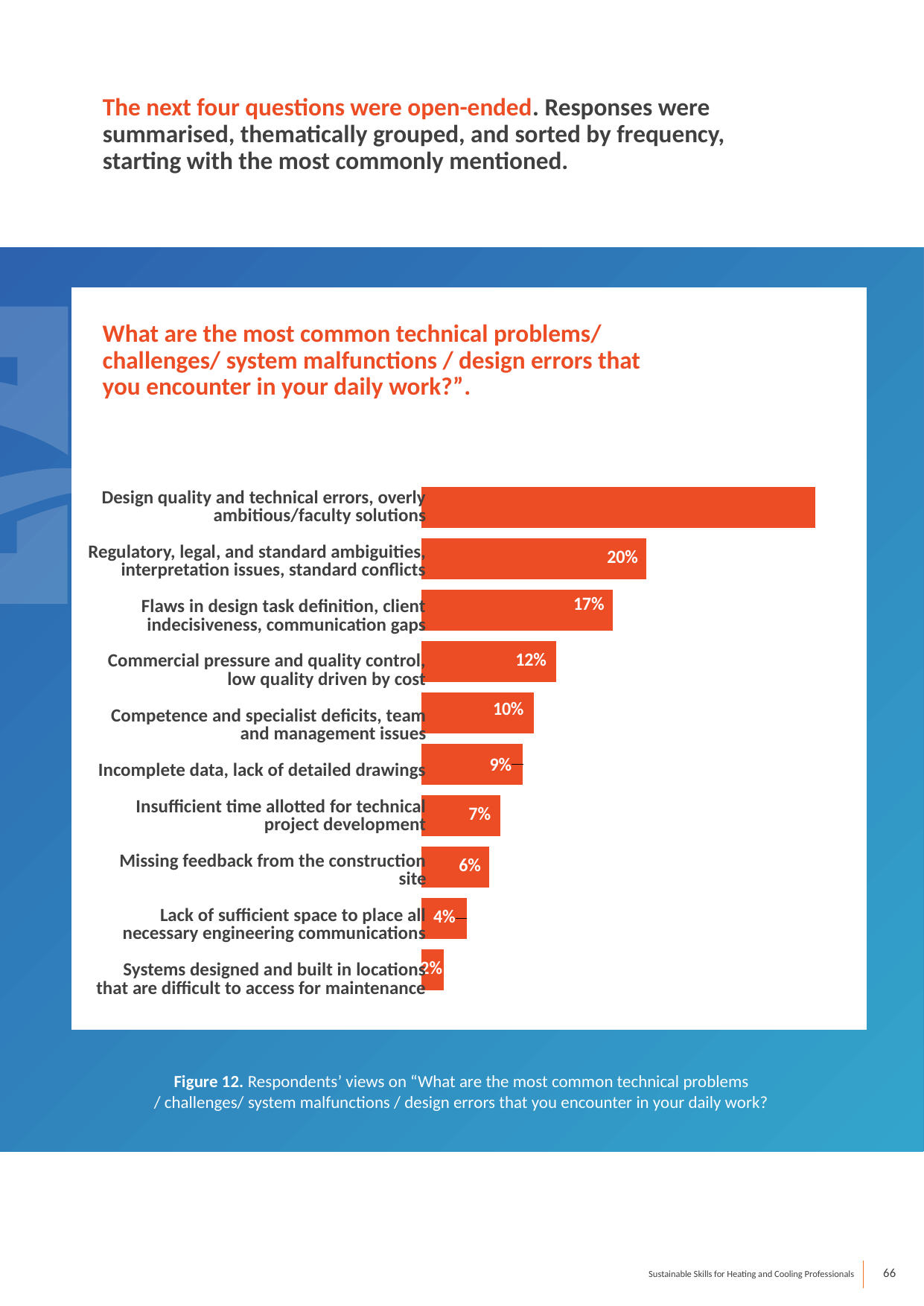
What is the value for "Missing feedback from the construction site"? 6% What figure number is given to this chart in the caption? Figure 12 What is the value for "Regulatory, legal, and standard ambiguities, interpretation issues, standard conflicts"? 20% What is the value for "Incomplete data, lack of detailed drawings"? 9% What kind of chart is shown on the slide? Bar chart What is the difference between the values for "Regulatory, legal, and standard ambiguities, interpretation issues, standard conflicts" and "Competence and specialist deficits, team and management issues"? 10% Which category has the longest bar in the chart? Design quality and technical errors, overly ambitious/faculty solutions What is the value for "Flaws in design task definition, client indecisiveness, communication gaps"? 17% How many categories are plotted in the chart? 10 What is the value for "Commercial pressure and quality control, low quality driven by cost"? 12% Which is larger: the value for "Insufficient time allotted for technical project development" or the value for "Lack of sufficient space to place all necessary engineering communications"? Insufficient time allotted for technical project development Which category has the lowest value in the chart? Systems designed and built in locations that are difficult to access for maintenance